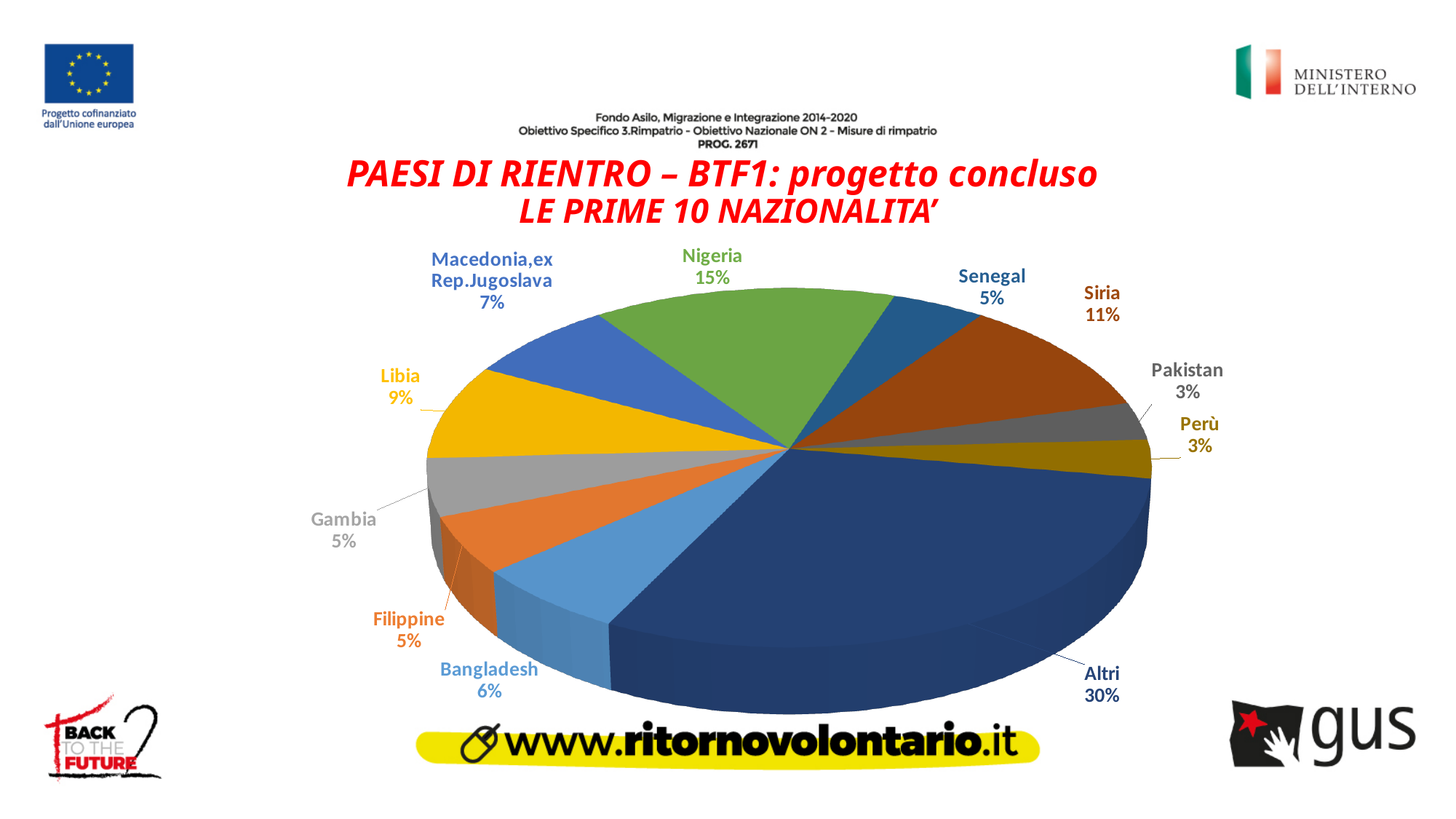
Which is larger, the share for Siria or the share for Libia? Siria Which two slices share the smallest percentage, 3%? Pakistan and Perù What percentage is shown for Libia? 9% What is the title of the chart? PAESI DI RIENTRO – BTF1: progetto concluso LE PRIME 10 NAZIONALITA' What percentage is shown for Siria? 11% How many slices does the pie chart have? 11 What share of the pie does Nigeria have? 15% Which slice of the pie is the largest? Altri What percentage is shown for Bangladesh? 6% What is the difference in percentage points between Altri and Nigeria? 15 Which named nationality (excluding Altri) has the largest share? Nigeria What kind of chart is shown on the slide? pie chart